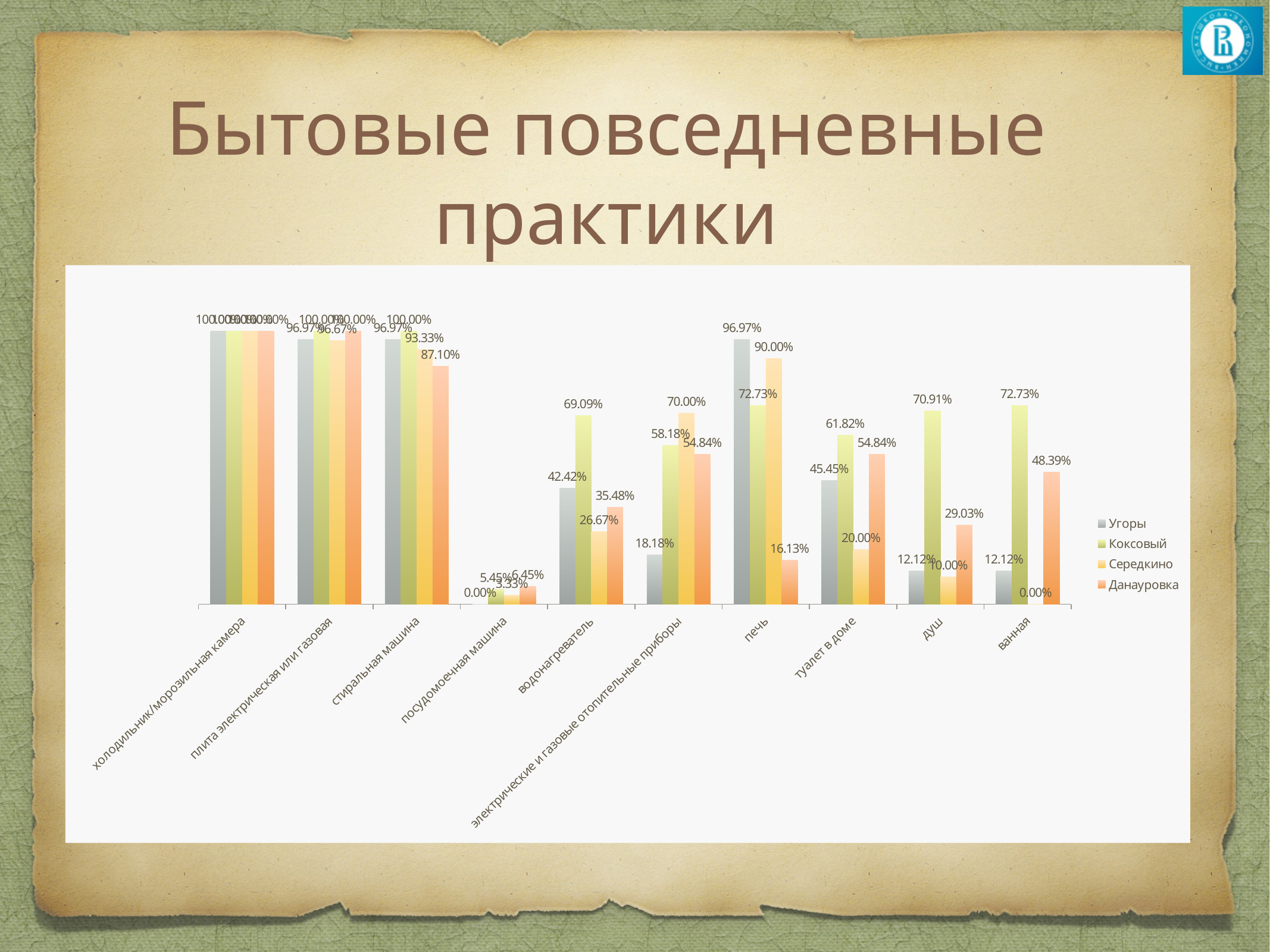
In the category стиральная машина, which is larger: the value for Середкино or the value for Данауровка? Середкино Which series has the highest value in the category душ? Коксовый What is the value for Коксовый in the category водонагреватель? 69.09% How many categories are shown on the x axis? 10 What is the value for Середкино in the category электрические и газовые отопительные приборы? 70.00% What is the value for Угоры in the category посудомоечная машина? 0.00% How many series does the legend list? 4 What type of chart is shown on the slide? bar chart What is the value for Данауровка in the category печь? 16.13% What is the difference between Коксовый and Угоры in the category туалет в доме? 16.37% Which series is shown in orange in the legend? Данауровка Which series has the lowest value in the category ванная? Середкино